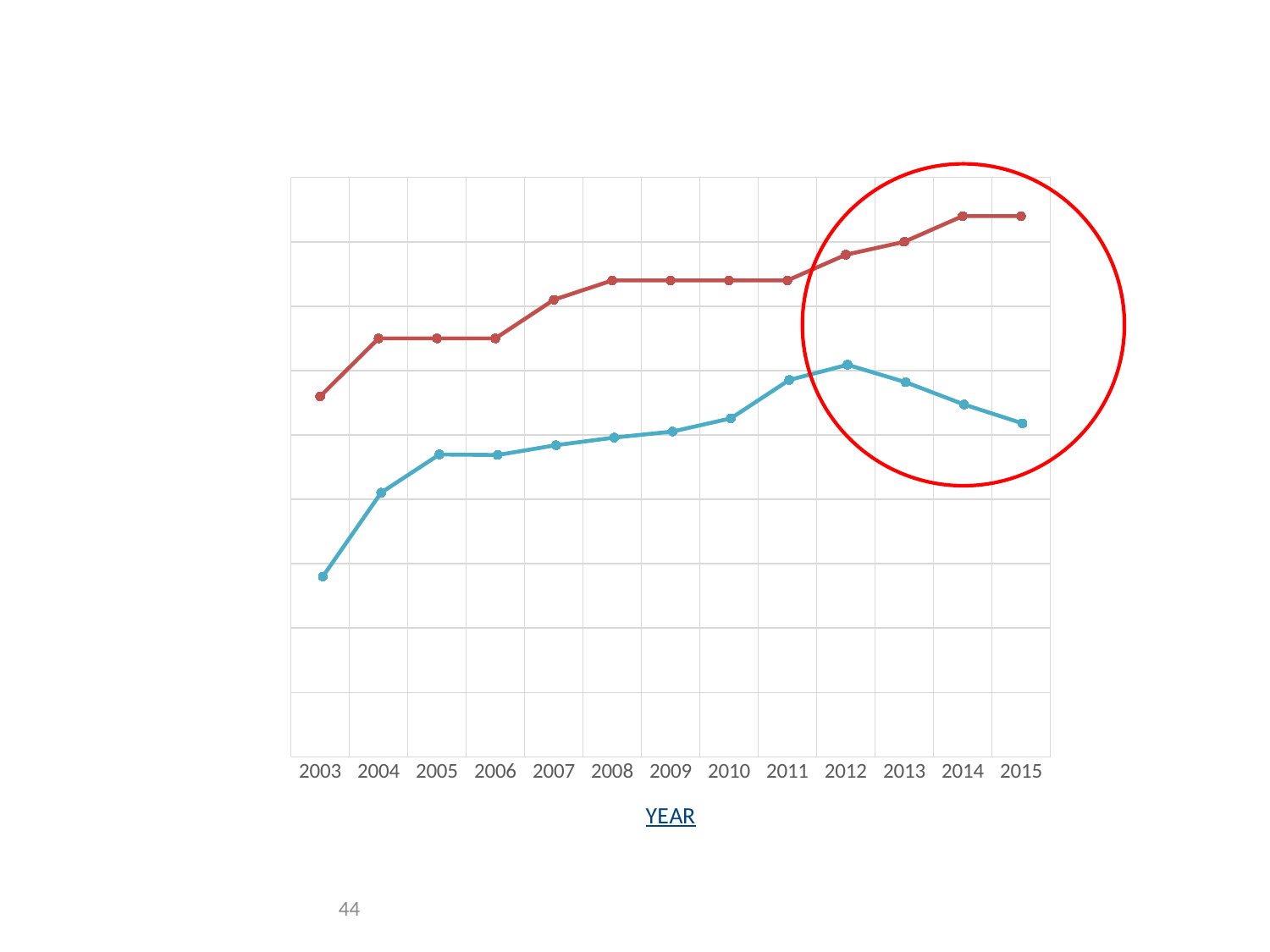
How many lines are plotted on the chart? 2 How many years are shown along the x axis of the chart? 13 What is the title of the x axis of the chart? YEAR In 2015, which line is higher, the red line or the blue line? the red line What is the last year shown on the x axis of the chart? 2015 In which year is the blue line at its lowest point? 2003 Does the red line generally rise or fall from 2003 to 2015? rise In which year is the red line at its lowest point? 2003 In which year does the blue line reach its highest point? 2012 What kind of chart is shown on the slide? line chart Does the blue line rise or fall between 2012 and 2015? fall What is the first year shown on the x axis of the chart? 2003